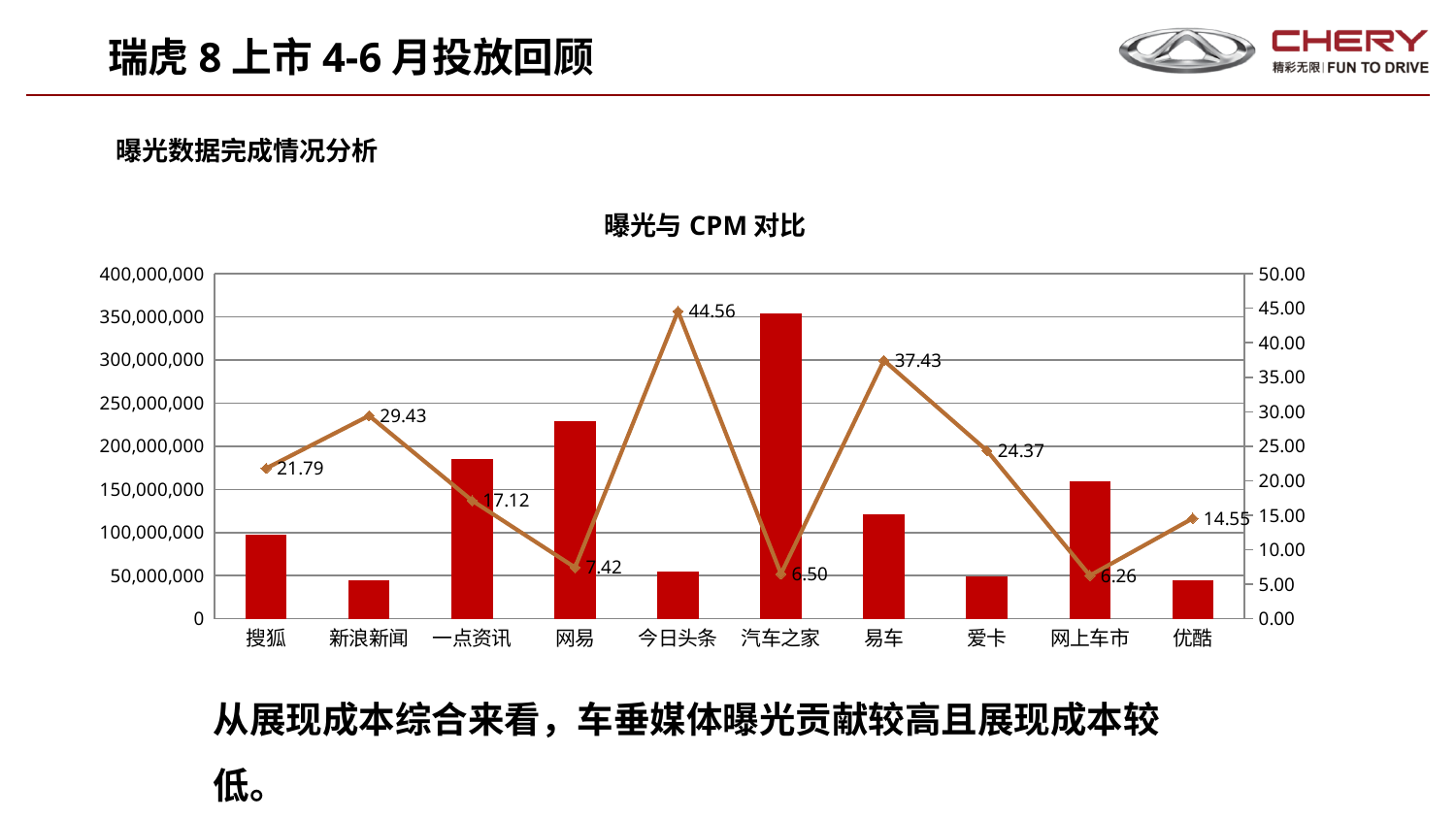
What kind of chart is this? Combination bar and line chart What is the CPM value plotted for 今日头条 on the line? 44.56 How many categories are shown on the x axis? 10 Which category has the lowest value on the line series? 网上车市 Is the bar value for 汽车之家 greater or less than 300,000,000? greater What is the CPM value plotted for 爱卡 on the line? 24.37 Is the bar value for 网易 greater or less than 200,000,000? greater Which has the larger line value, 新浪新闻 or 搜狐? 新浪新闻 Which category has the highest value on the line series? 今日头条 What is the CPM value plotted for 网上车市 on the line? 6.26 Which category has the tallest bar? 汽车之家 What is the difference between the line values for 易车 and 爱卡? 13.06